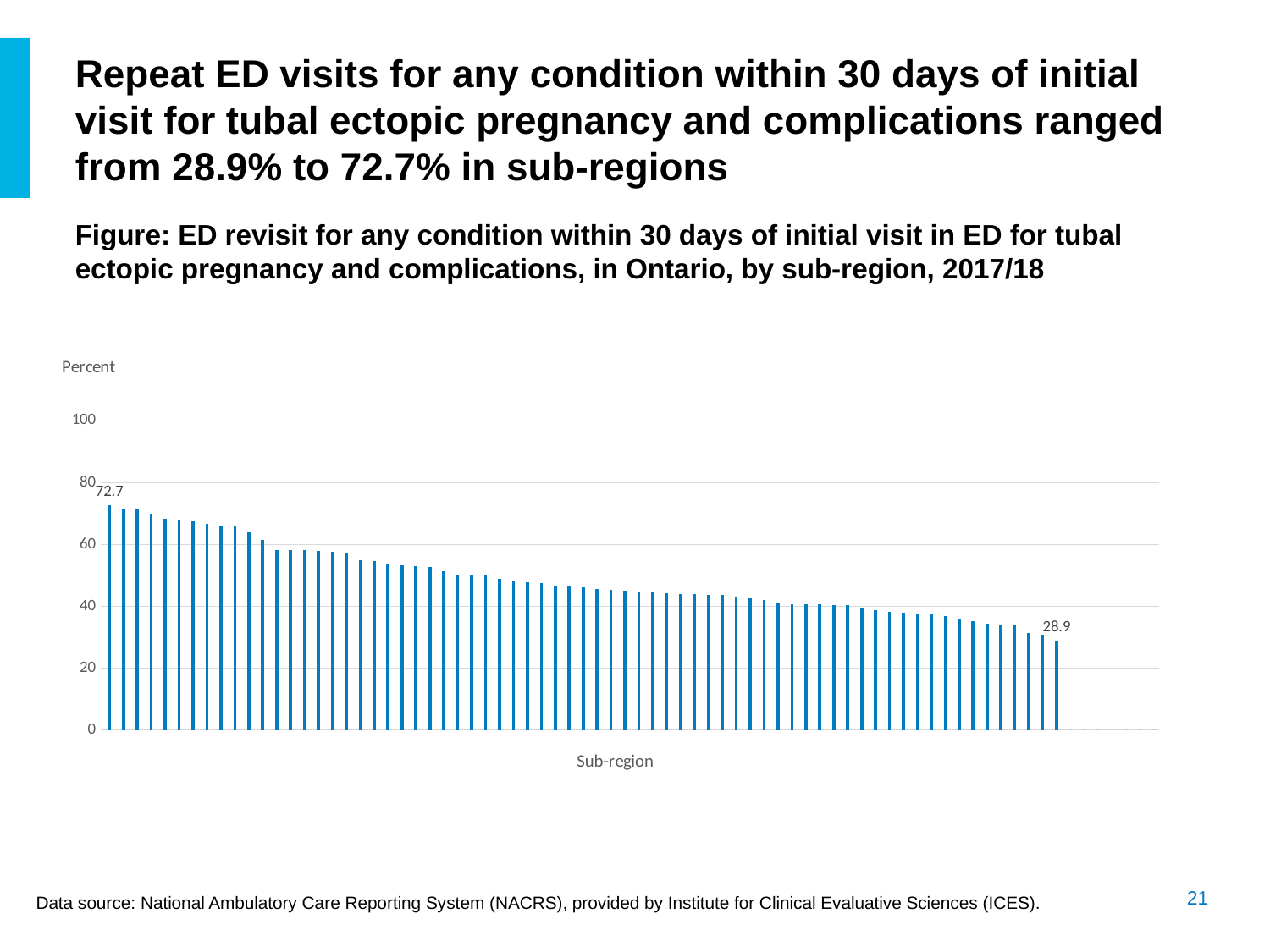
Is the value of the tallest bar greater or less than 60? greater Is the value of the shortest bar greater or less than 20? greater What is the difference between the highest and lowest values shown on the chart? 43.8 Which is larger, the leftmost bar or the rightmost bar? The leftmost bar What is the highest value shown on the chart? 72.7 Do the values rise or fall from left to right along the x axis? Fall What is the lowest value shown on the chart? 28.9 Is the value of the shortest bar greater or less than 40? less What is the label of the vertical axis? Percent What is the label of the horizontal axis? Sub-region What kind of chart is shown on the slide? Bar chart